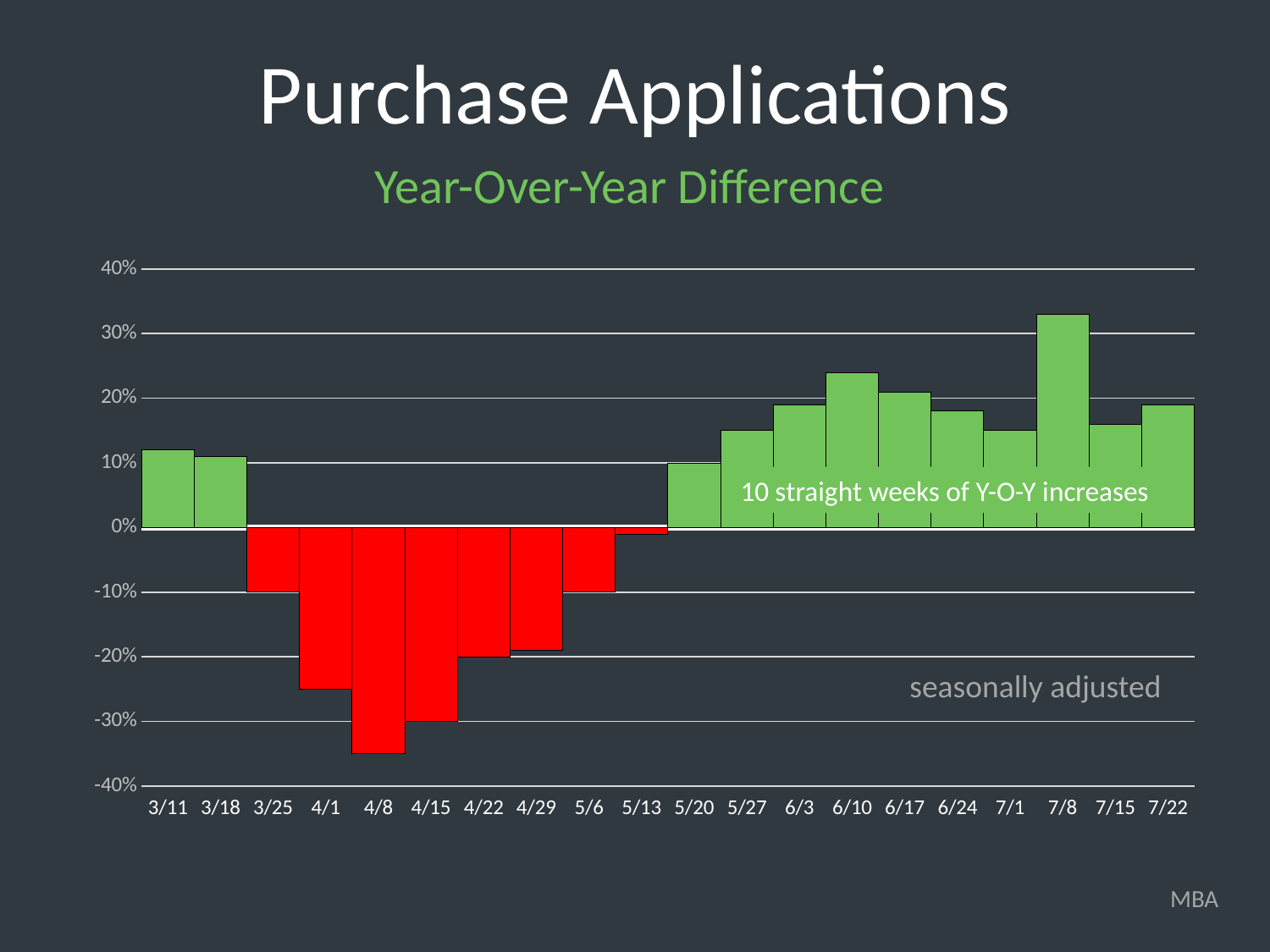
Is the value for 7/8 greater or less than 30%? greater Which week has the lowest year-over-year difference? 4/8 Which week has the lower value, 4/8 or 4/15? 4/8 Is the value for 4/1 greater or less than -20%? less Which week has the larger value, 6/10 or 6/17? 6/10 Is the value for 6/10 greater or less than 20%? greater What kind of chart is shown on the slide? bar chart Do the values rise or fall from 3/25 to 4/8? fall Which week has the highest year-over-year difference? 7/8 How many weekly dates are shown on the x axis of the chart? 20 What annotation is written over the green bars on the chart? 10 straight weeks of Y-O-Y increases